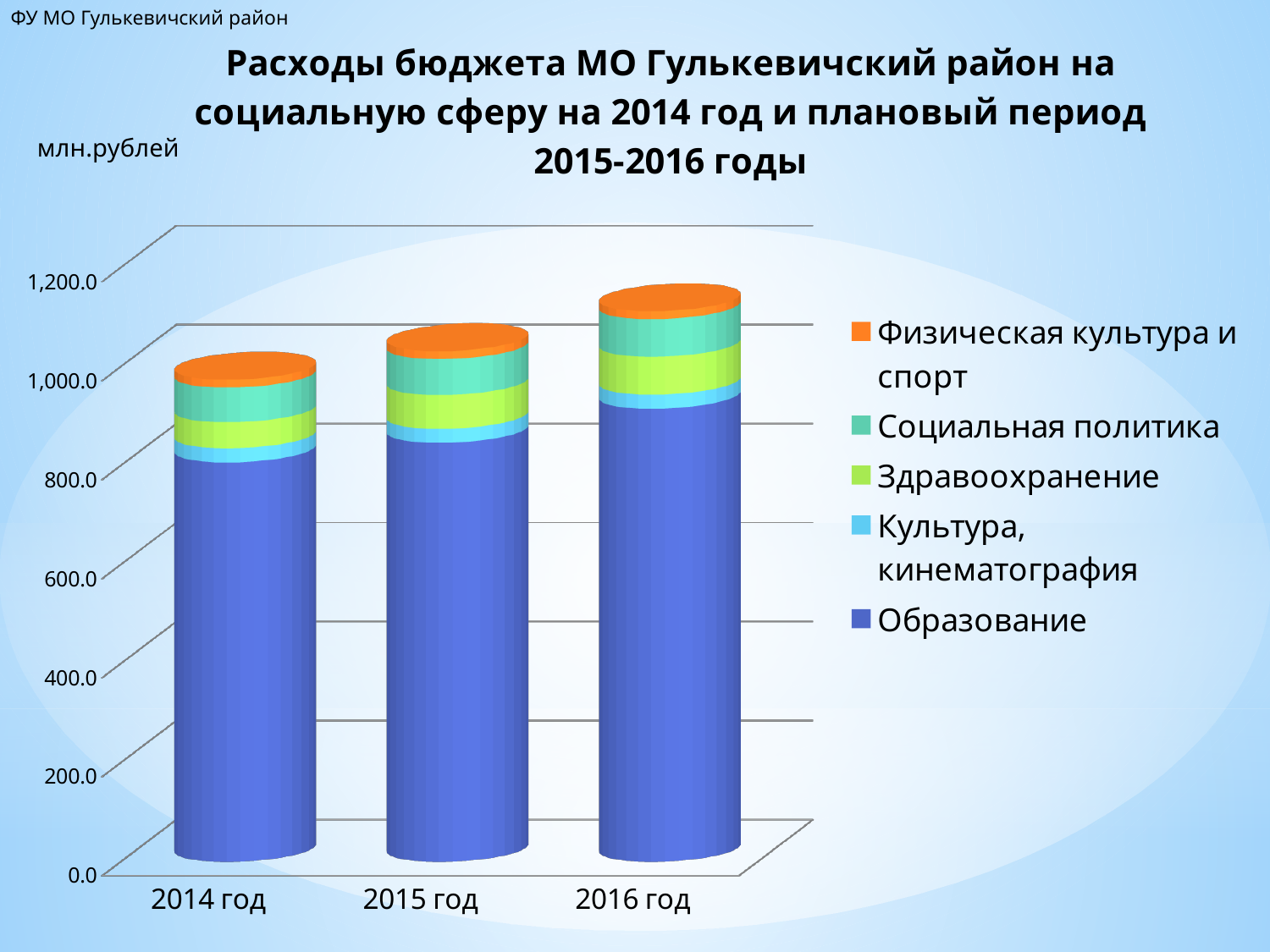
Is the total bar for 2016 год greater or less than 1,000.0? greater What unit is indicated for the values on the chart? млн.рублей What kind of chart is shown on the slide? Stacked bar chart Is the Образование segment for 2016 год greater or less than 800.0? greater Is the total bar for 2014 год greater or less than 800.0? greater Do the total expenditures rise or fall from 2014 to 2016? Rise How many years (categories) are shown on the x axis? 3 How many series does the legend list? 5 Which year has the highest total bar? 2016 год Which is larger, the total bar for 2016 год or for 2014 год? 2016 год Which series makes up the largest part of each bar? Образование Which year has the lowest total bar? 2014 год